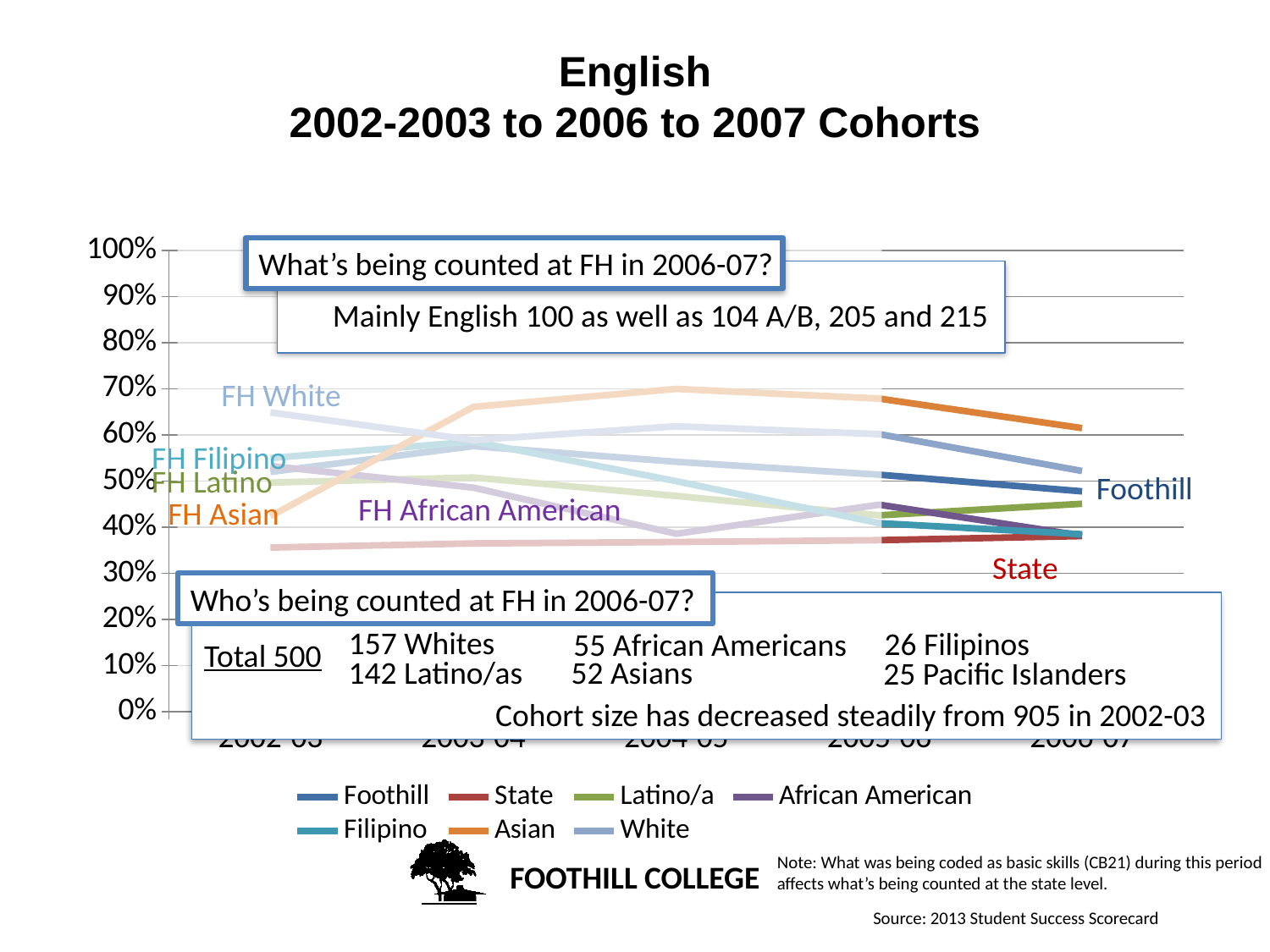
Is the value for State in 2006-07 greater or less than 40%? less Is the value for Asian in 2005-06 greater or less than 60%? greater Is the value for Asian in 2006-07 greater or less than 50%? greater Does the Asian series rise or fall from 2005-06 to 2006-07? fall Does the Foothill series rise or fall from 2005-06 to 2006-07? fall What kind of chart is shown on the slide? line chart Which series has the highest value in 2006-07? Asian What colour is the Asian series in the legend? orange Which is larger in 2006-07, the value for Asian or the value for Foothill? Asian Which is larger in 2006-07, the value for Asian or the value for State? Asian How many series does the legend list? 7